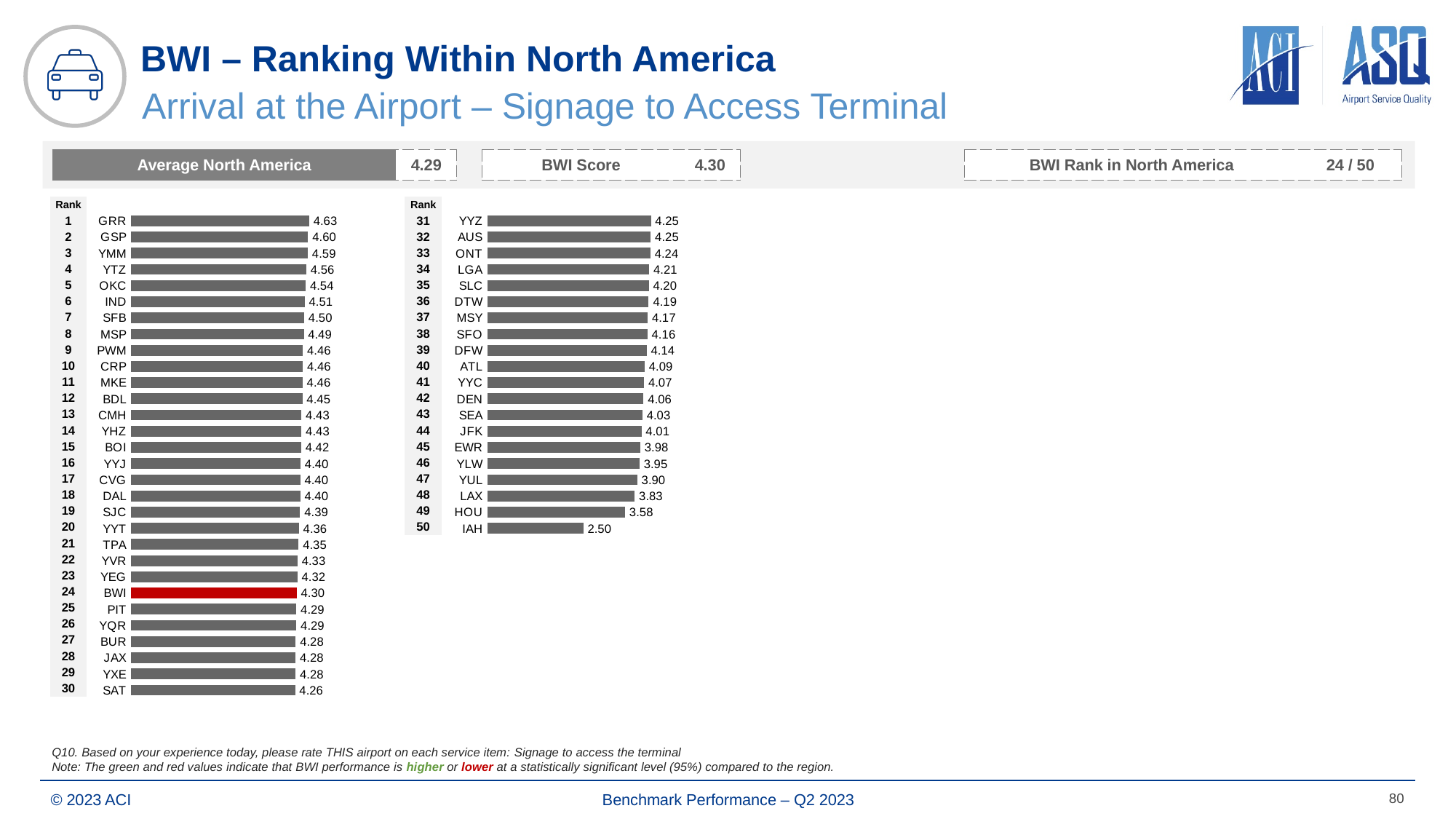
What kind of chart is used to show the airport rankings on this slide? Bar chart In the right chart (ranks 31-50), which has the larger value, YYZ or HOU? YYZ In the right chart (ranks 31-50), do the values rise or fall going down the list from rank 31 to rank 50? Fall How many airports are plotted in the right chart (ranks 31-50)? 20 How many airports are plotted in the left chart (ranks 1-30)? 30 In the left chart (ranks 1-30), which airport's bar is coloured red? BWI In the left chart (ranks 1-30), what is the difference between the values for GRR and BWI? 0.33 In the right chart (ranks 31-50), which airport has the lowest value? IAH In the left chart (ranks 1-30), what is the value shown for BWI? 4.30 In the right chart (ranks 31-50), what is the difference between the values for HOU and IAH? 1.08 In the left chart (ranks 1-30), which airport has the highest value? GRR In the right chart (ranks 31-50), what is the value shown for IAH? 2.50